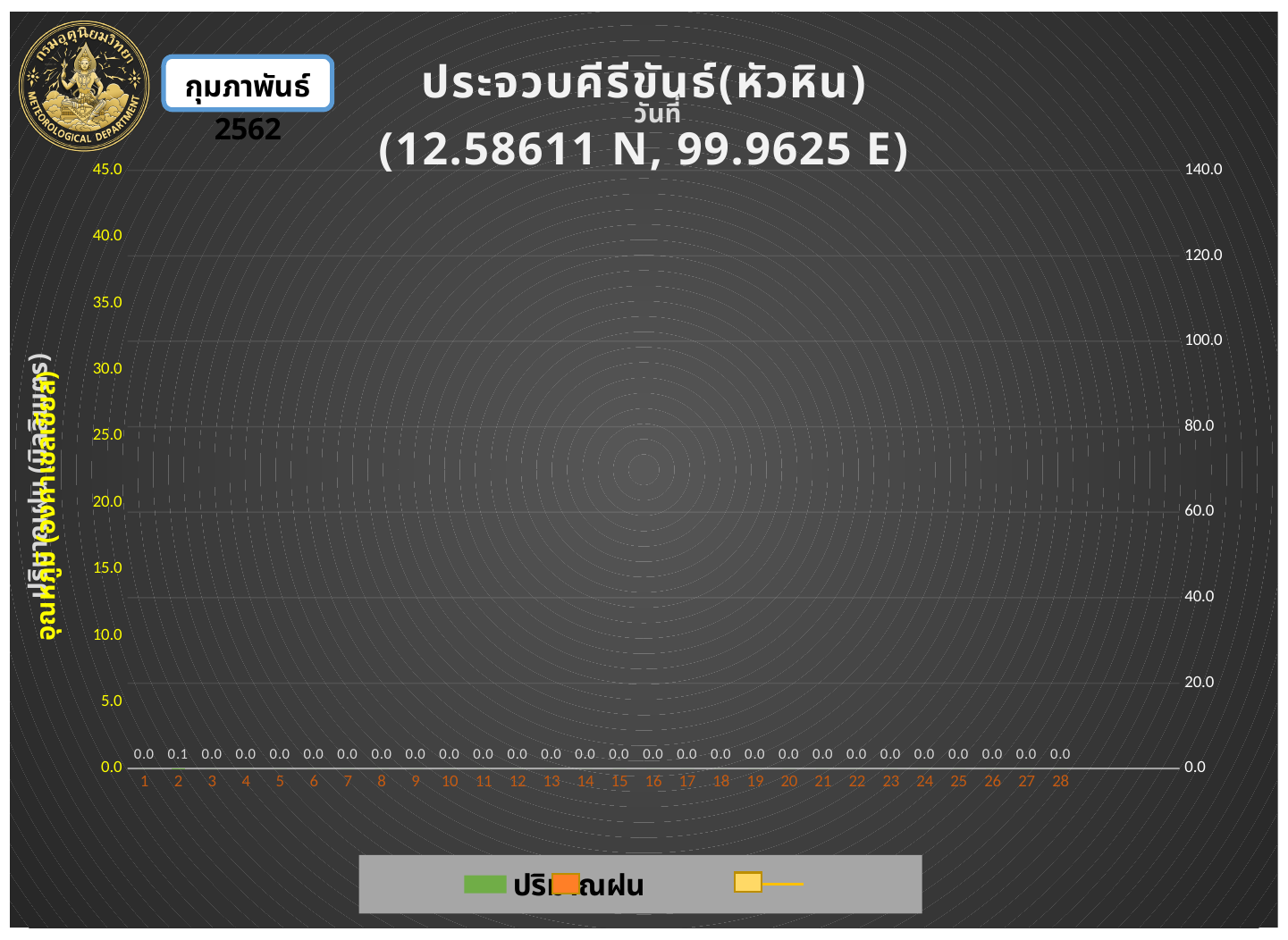
What is the highest tick label on the left vertical axis? 45.0 What is the difference between the values for day 2 and day 3? 0.1 What is the value printed for day 15? 0.0 Is the value for day 2 greater or less than 5.0 on the left axis? less Which is larger, the value for day 2 or the value for day 10? day 2 What is the highest tick label on the right vertical axis? 140.0 What is the value printed for day 1? 0.0 Which day has the highest printed value? 2 How many days are shown on the x axis? 28 What is the value printed for day 28? 0.0 What is the rainfall value printed for day 2? 0.1